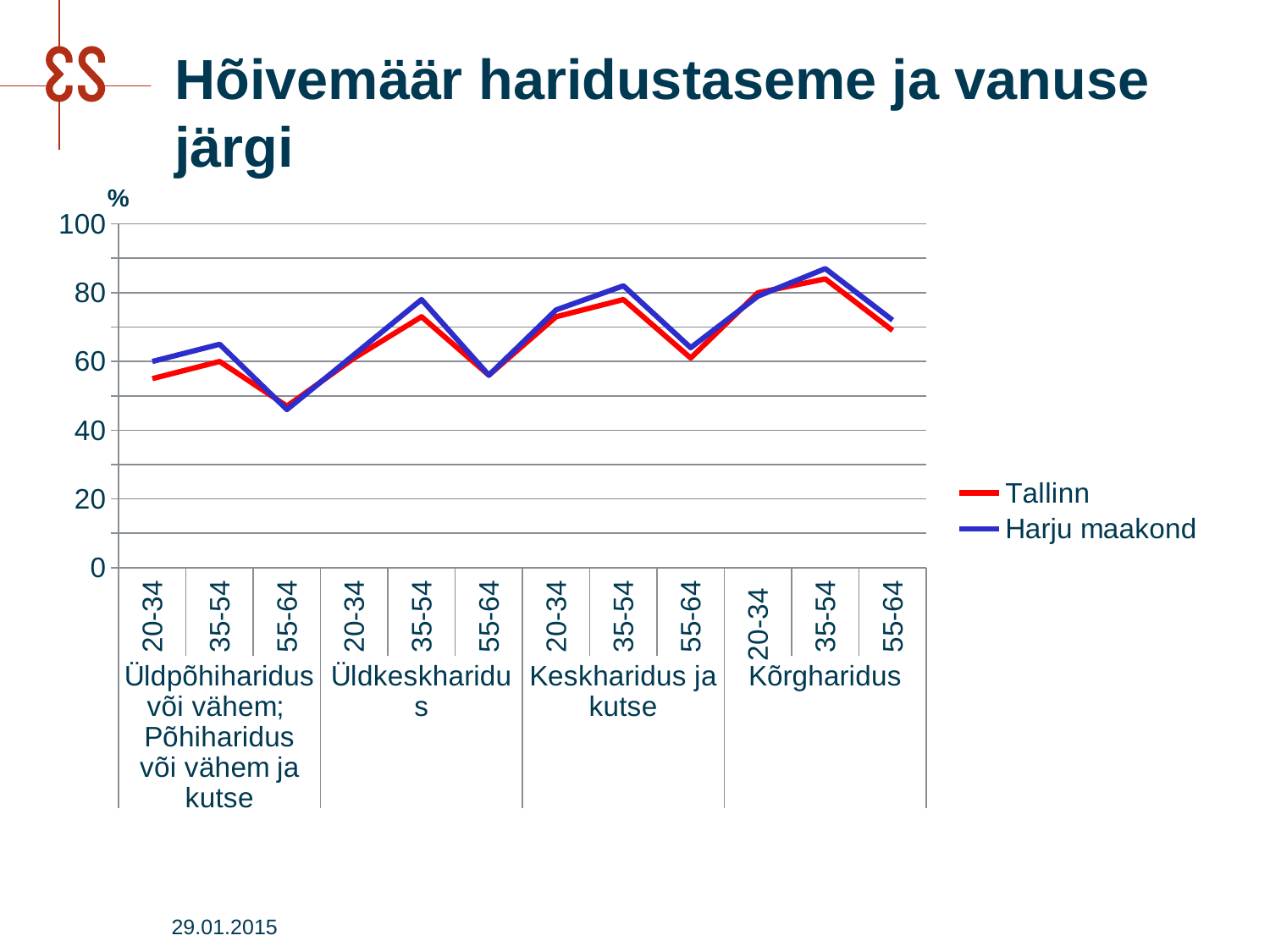
Is the Harju maakond value for Üldpõhiharidus 55-64 greater or less than 60? less For which education level and age group does the Harju maakond line reach its highest value? Kõrgharidus, 35-54 How many education-level groups are shown on the x axis? 4 How many series does the legend list? 2 What kind of chart is shown on the slide? line chart How many data points does each line have along the x axis? 12 For which education level and age group does the Tallinn line reach its lowest value? Üldpõhiharidus või vähem; Põhiharidus või vähem ja kutse, 55-64 Is the Tallinn value for Kõrgharidus 35-54 greater or less than 80? greater Within Kõrgharidus, does the Tallinn line rise or fall from the 35-54 age group to the 55-64 age group? fall For Üldkeskharidus 35-54, which series has the higher value, Tallinn or Harju maakond? Harju maakond Is the Tallinn value for Keskharidus ja kutse 35-54 greater or less than 60? greater What colour is the Tallinn line in the legend? red